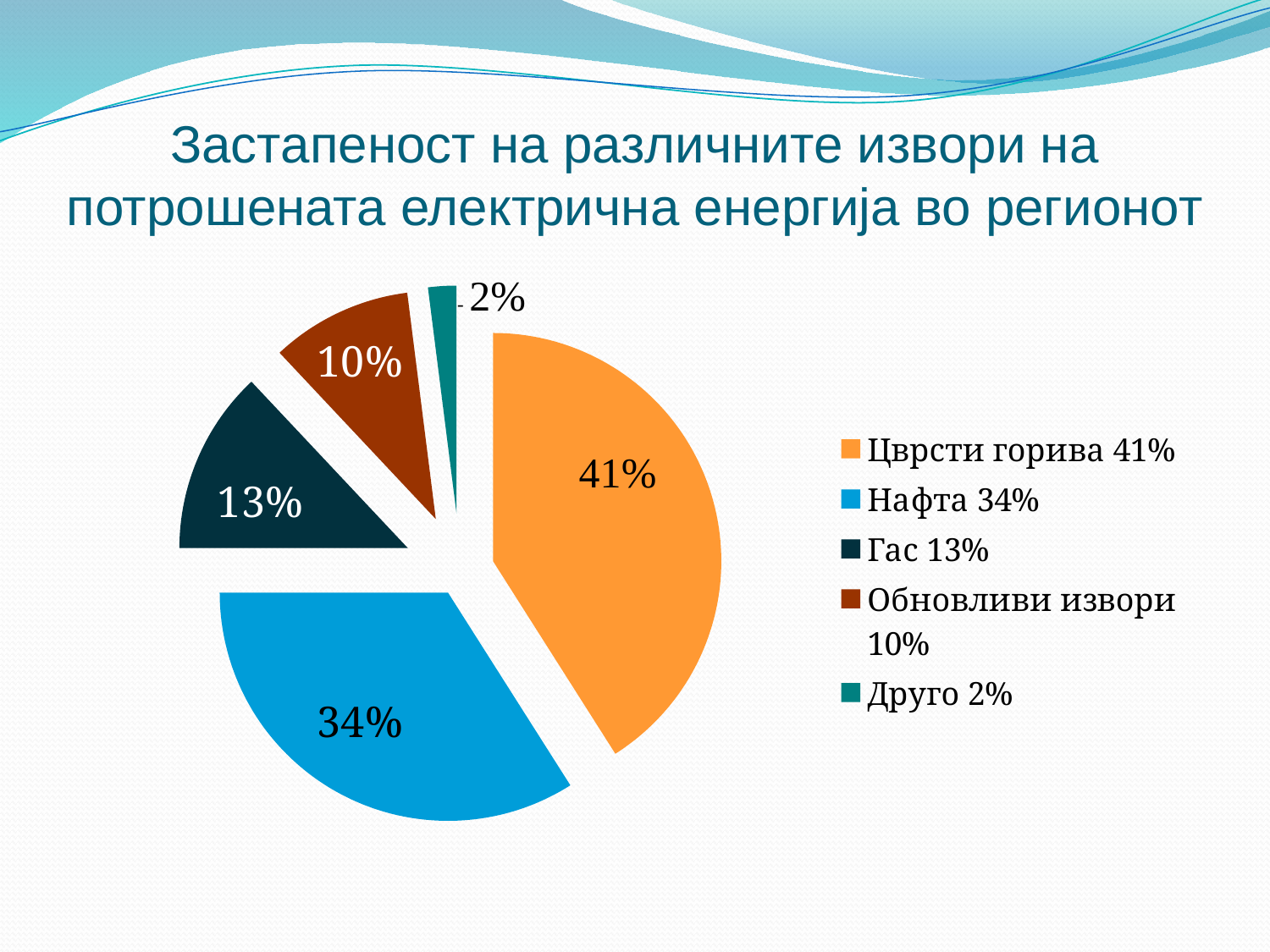
How many categories does the pie chart have? 5 What is the difference in percentage points between Цврсти горива and Нафта? 7% What share of the pie does Обновливи извори have? 10% What share of the pie does Друго have? 2% Which category has the largest slice of the pie? Цврсти горива What kind of chart is shown on the slide? pie chart What colour is the slice for Нафта? blue Which category has the smallest slice of the pie? Друго What share of the pie does Гас have? 13% Which is larger, the share for Гас or the share for Обновливи извори? Гас